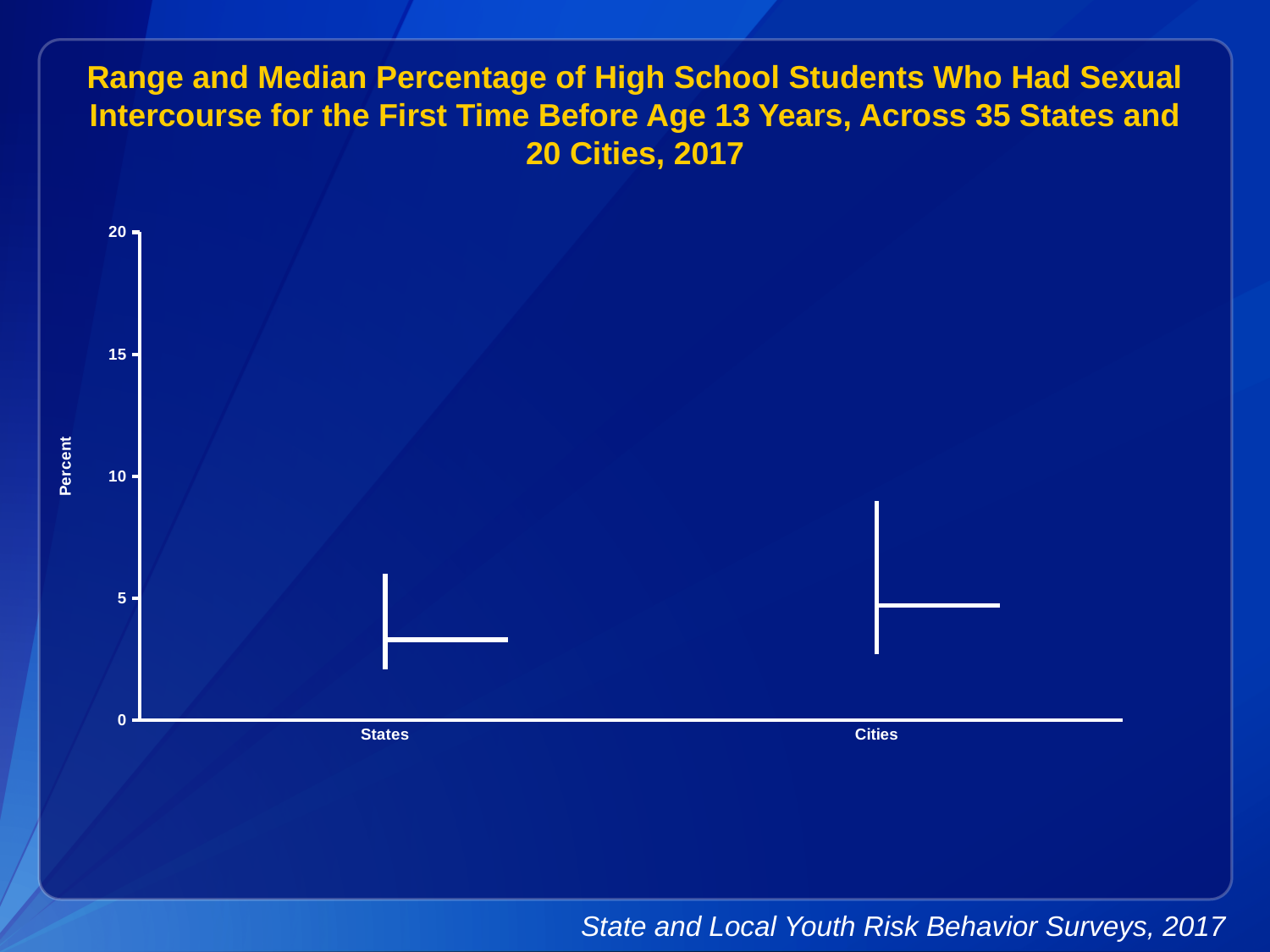
Is the top of the range for Cities greater or less than 10? less Is the top of the range for Cities greater or less than 5? greater Which category has the higher top of its range, States or Cities? Cities Which category has the higher median value, States or Cities? Cities Which category has the lower median value? States What is the label of the y axis? Percent What are the two categories shown on the x axis? States and Cities What is the highest value shown on the y axis? 20 Is the bottom of the range for States greater or less than 5? less How many categories are shown on the x axis of the chart? 2